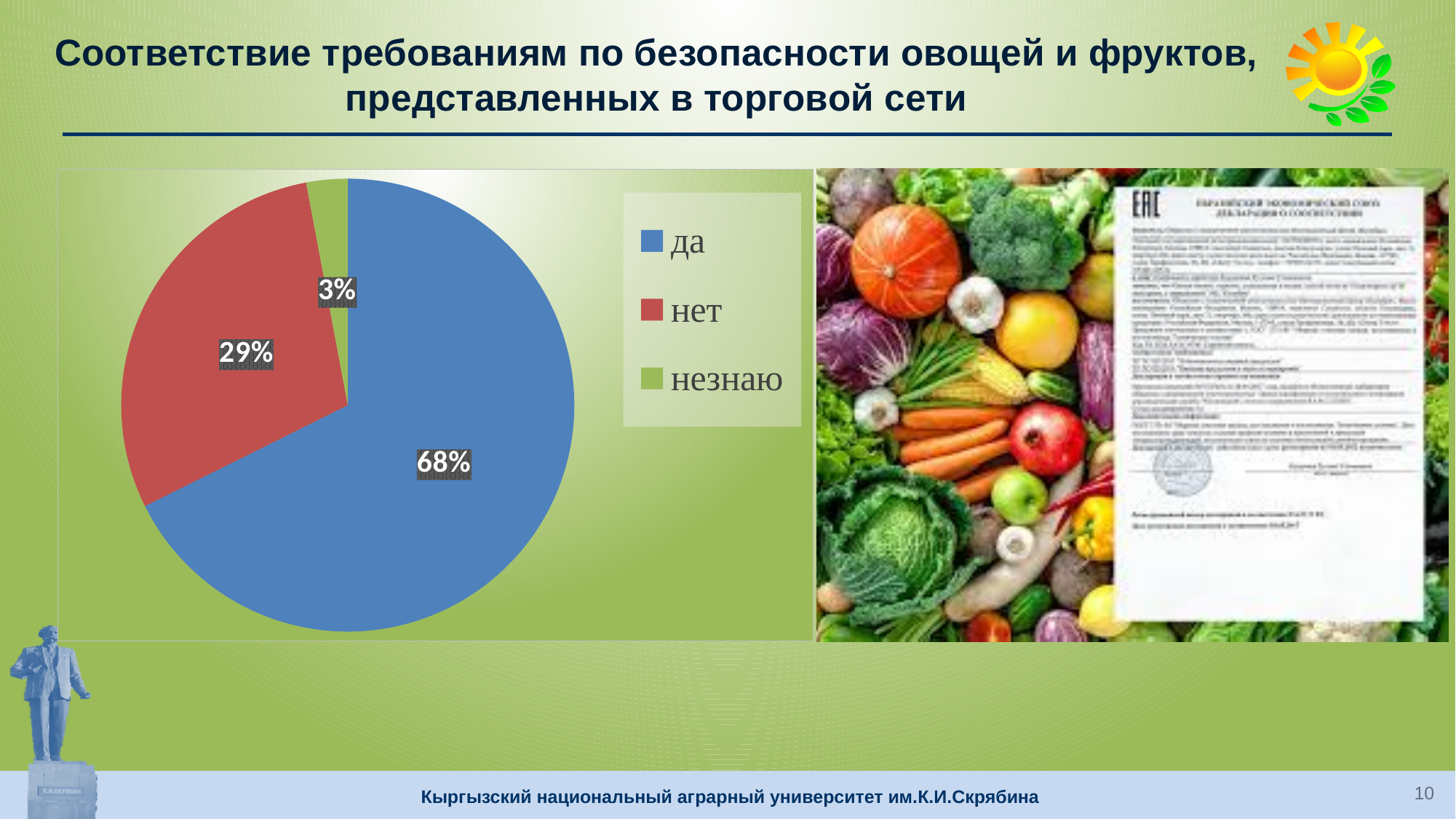
What share of the pie does "да" take? 68% What colour is the slice for "да"? blue What kind of chart is shown on the slide? pie chart What is the difference in percentage points between "нет" and "незнаю"? 26% What colour is the slice for "нет"? red Which is larger, the slice for "нет" or the slice for "незнаю"? нет What share of the pie does "незнаю" take? 3% What is the difference in percentage points between "да" and "нет"? 39% What share of the pie does "нет" take? 29% Which category has the largest slice of the pie? да How many categories does the pie chart have? 3 Which category has the smallest slice of the pie? незнаю